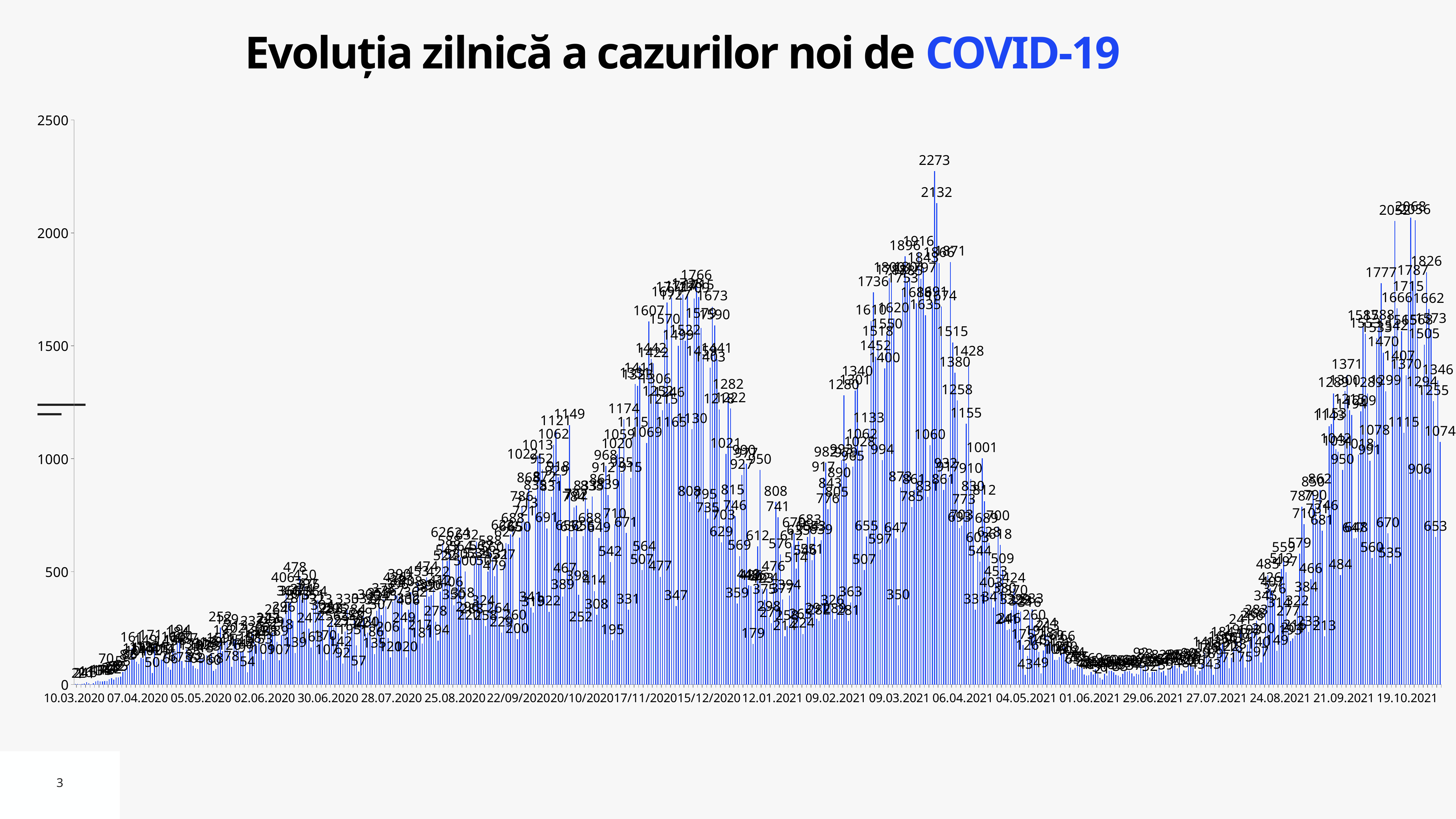
What is the first date shown on the horizontal axis? 10.03.2020 Are the values around 01.06.2021 greater or less than 500? less What kind of chart is shown on the slide? bar chart Do the values rise or fall between 06.04.2021 and 01.06.2021? fall Do the values rise or fall between 29.06.2021 and 19.10.2021? rise What is the title of the chart? Evoluția zilnică a cazurilor noi de COVID-19 What is the highest value labeled in the wave around 15/12/2020? 1766 Is the peak of the wave around 15/12/2020 greater or less than 2000? less What is the highest tick value shown on the vertical axis? 2500 What is the last date shown on the horizontal axis? 19.10.2021 What is the highest value labeled on the chart? 2273 Is the highest value on the chart greater or less than 2000? greater